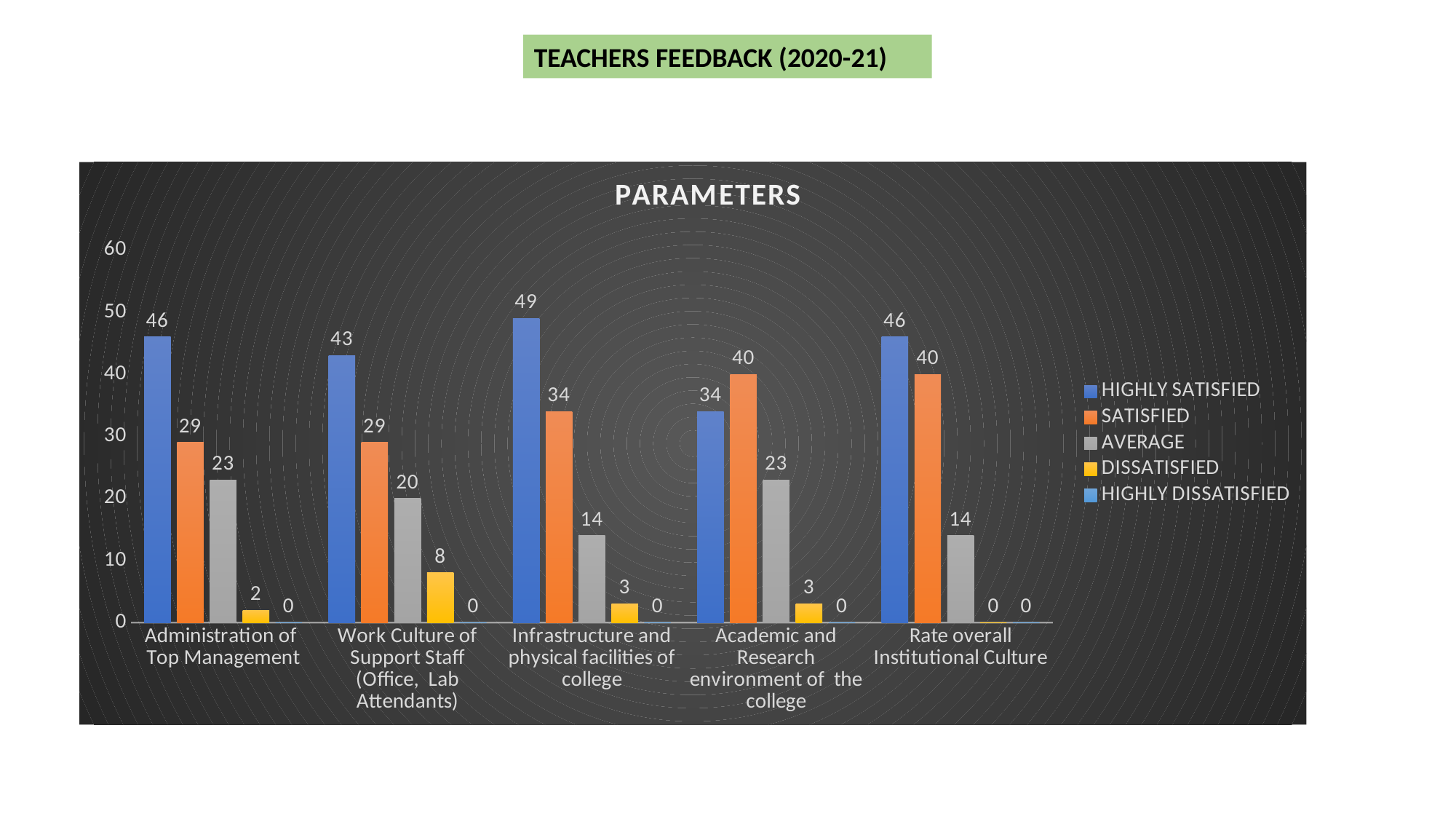
Which category has the lowest HIGHLY SATISFIED value? Academic and Research environment of the college What is the difference between the HIGHLY SATISFIED and SATISFIED values for Administration of Top Management? 17 Which is larger for Academic and Research environment of the college: HIGHLY SATISFIED or SATISFIED? SATISFIED How many series does the legend list? 5 What kind of chart is shown on the slide? Bar chart What is the SATISFIED value for Academic and Research environment of the college? 40 What is the AVERAGE value for Rate overall Institutional Culture? 14 How many categories are shown on the x axis? 5 Which category has the highest HIGHLY SATISFIED value? Infrastructure and physical facilities of college What is the HIGHLY SATISFIED value for Infrastructure and physical facilities of college? 49 What is the DISSATISFIED value for Work Culture of Support Staff (Office, Lab Attendants)? 8 What is the title of the chart? PARAMETERS